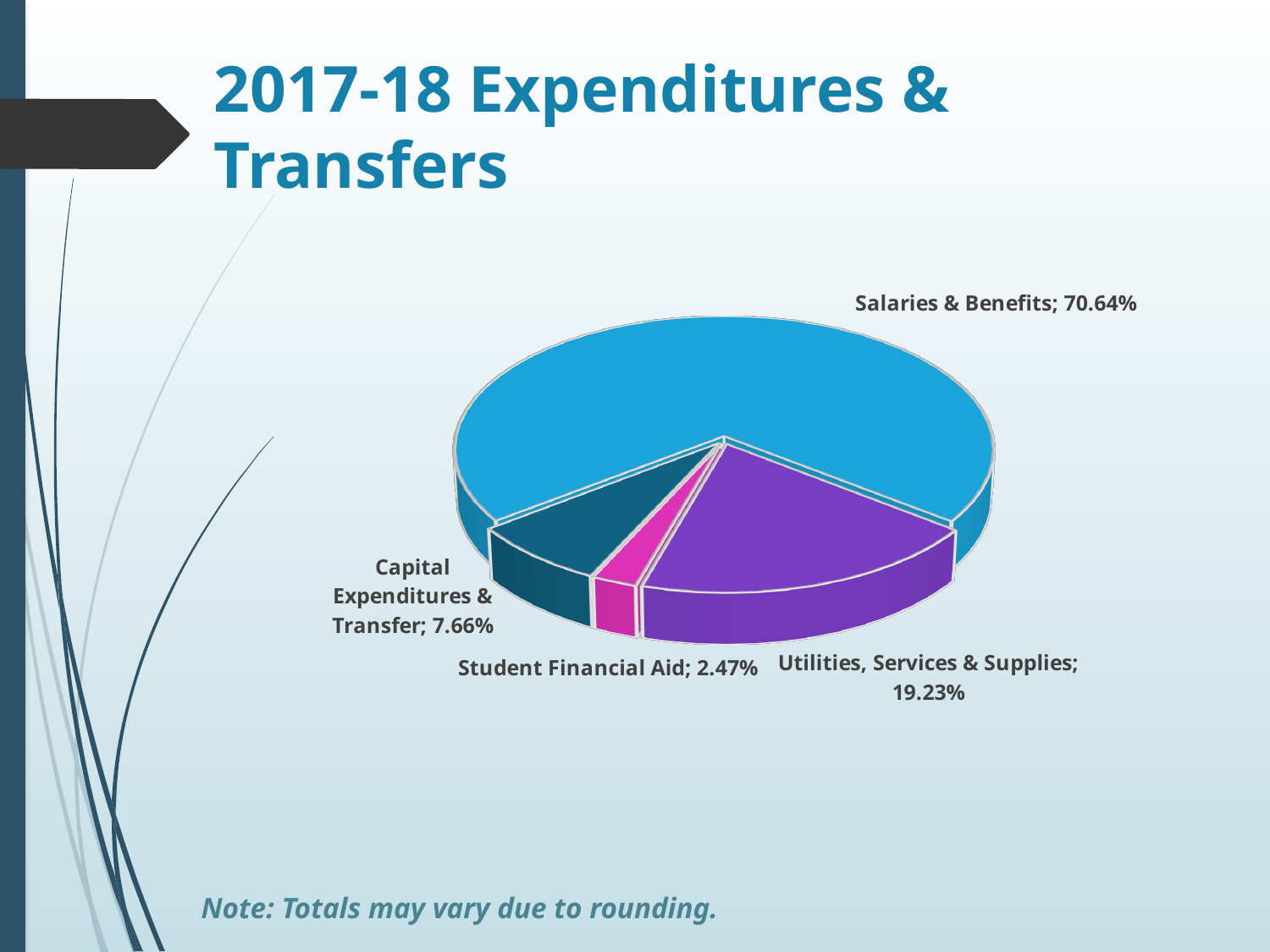
Which category has the largest share of the pie? Salaries & Benefits What share of 2017-18 expenditures and transfers is Salaries & Benefits? 70.64% What type of chart is shown on the slide? Pie chart What percentage does the Utilities, Services & Supplies slice represent? 19.23% What is the difference in percentage points between Salaries & Benefits and Utilities, Services & Supplies? 51.41 What percentage is labelled for Student Financial Aid? 2.47% What colour is the Salaries & Benefits slice? Light blue What is the title of the chart on the slide? 2017-18 Expenditures & Transfers Which is larger: Capital Expenditures & Transfer or Student Financial Aid? Capital Expenditures & Transfer What is the value shown for Capital Expenditures & Transfer? 7.66% How many slices does the pie chart have? 4 Which category has the smallest share of the pie? Student Financial Aid